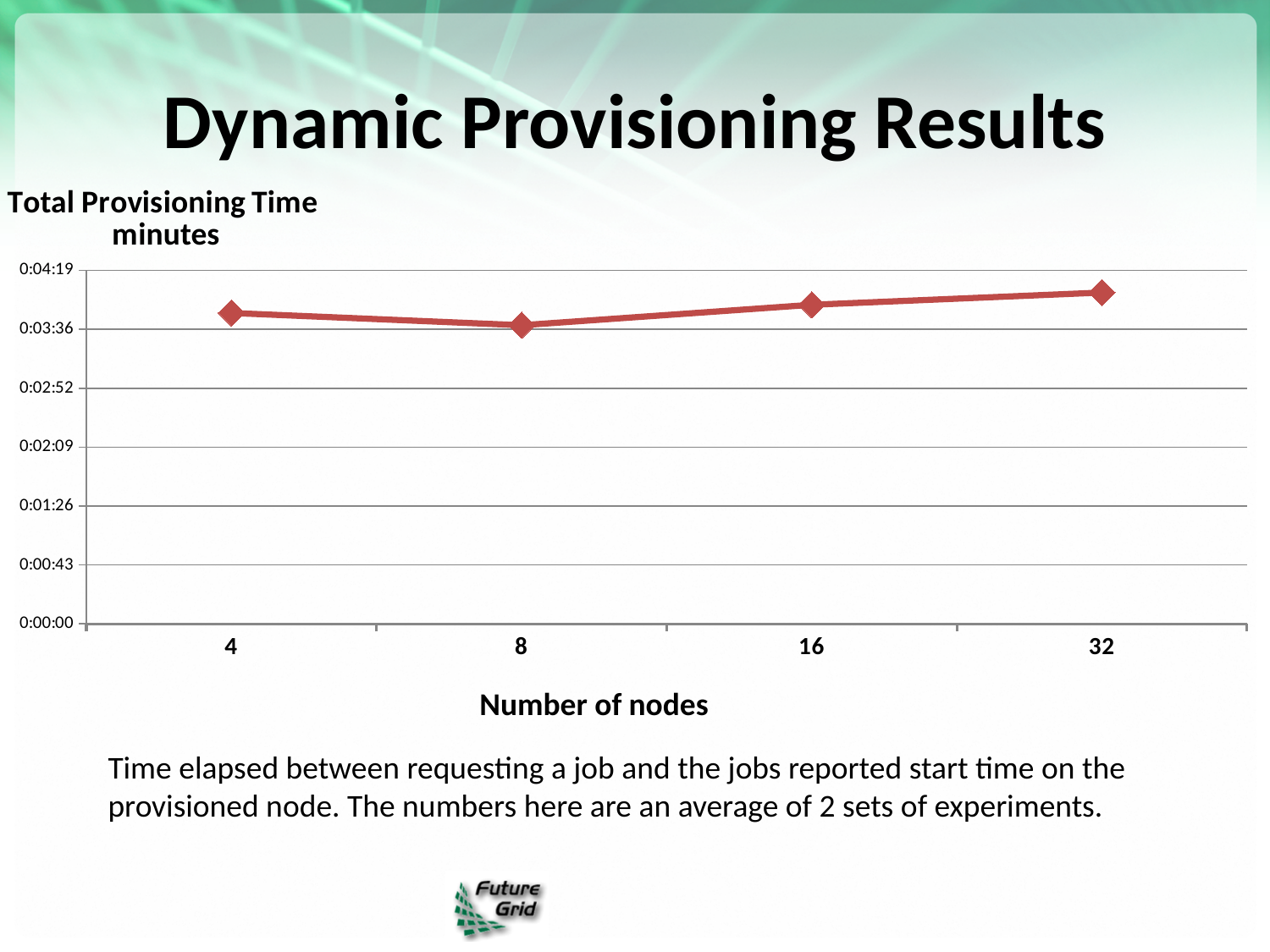
Is the value for 16 nodes greater or less than 0:02:52? greater Is the value for 4 nodes greater or less than 0:04:19? less What kind of chart is shown on the slide? line chart What is the title of the chart? Total Provisioning Time minutes For which number of nodes is the total provisioning time lowest? 8 Which has a larger total provisioning time, 8 nodes or 32 nodes? 32 nodes Which has a larger total provisioning time, 4 nodes or 32 nodes? 32 nodes How many data points are plotted on the line? 4 From 8 nodes to 32 nodes, does the total provisioning time rise or fall? rise Is the value for 32 nodes greater or less than 0:03:36? greater What is the label of the x axis? Number of nodes For which number of nodes is the total provisioning time highest? 32